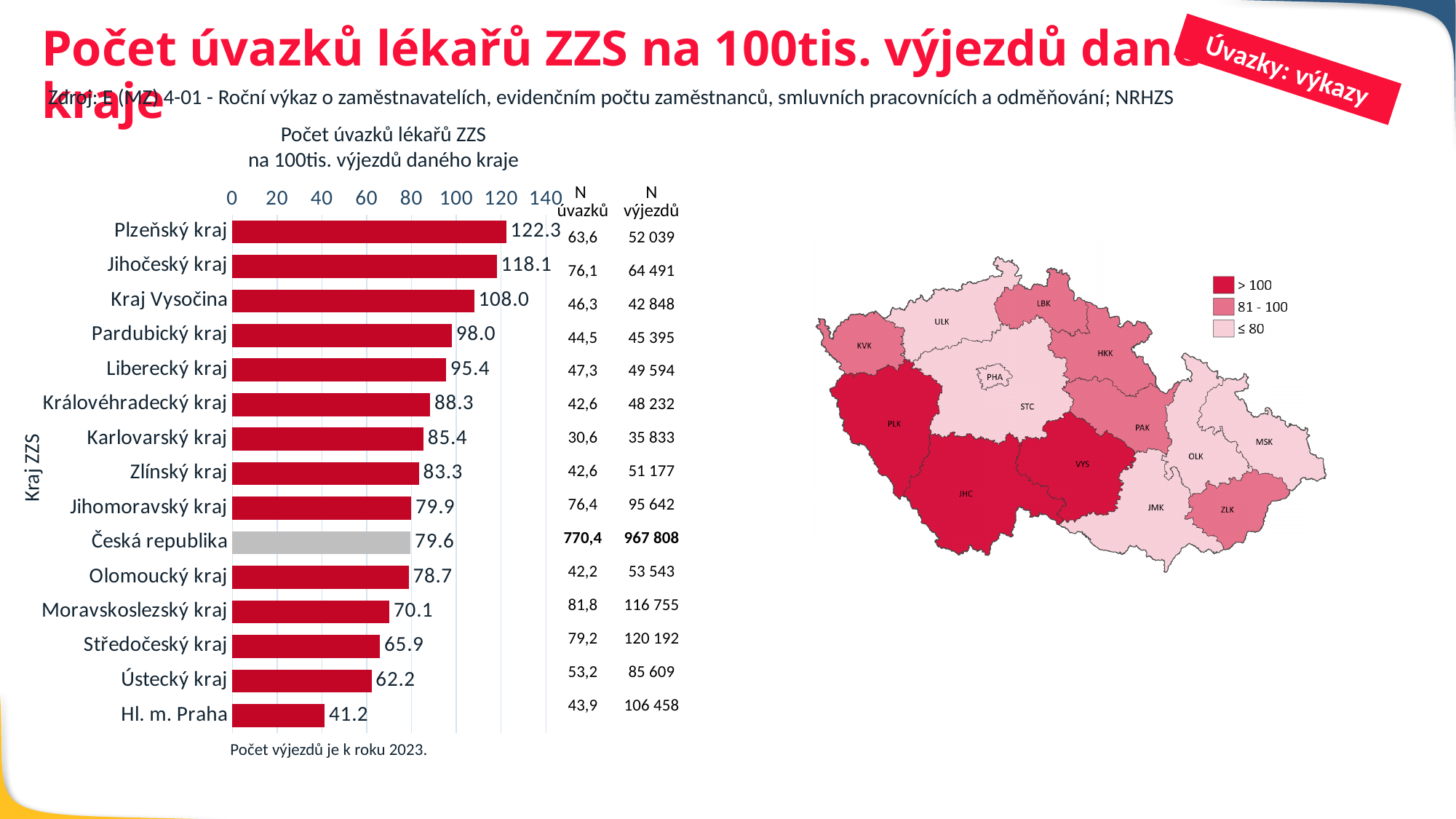
What is the value shown for Česká republika in the bar chart? 79.6 Which is larger, the value for Liberecký kraj or the value for Královéhradecký kraj? Liberecký kraj Which category has the lowest value in the bar chart? Hl. m. Praha What kind of chart is shown on the left of the slide? bar chart What is the difference between the values for Kraj Vysočina and Pardubický kraj? 10.0 What is the value for Hl. m. Praha in the bar chart? 41.2 Which bar in the chart is coloured grey instead of red? Česká republika Which category has the highest value in the bar chart? Plzeňský kraj What is the difference between the values for Plzeňský kraj and Jihočeský kraj? 4.2 How many bars are shown in the bar chart? 15 What is the value for Plzeňský kraj in the bar chart? 122.3 Is the value for Ústecký kraj greater or less than 80? less